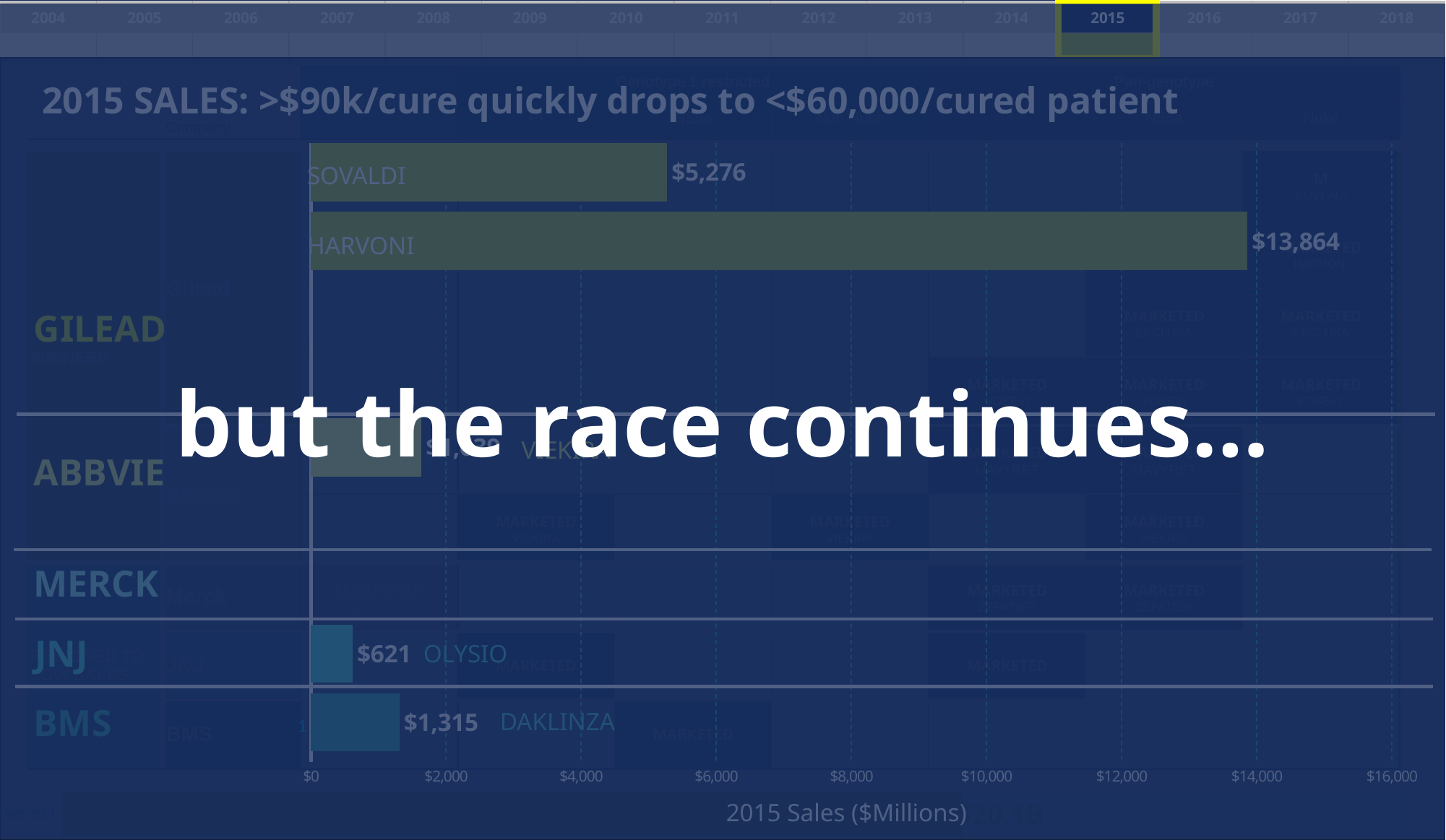
What kind of chart is shown on the slide? Bar chart How many drug bars are plotted on the chart? 5 What is the 2015 sales value shown for DAKLINZA? $1,315 What is the 2015 sales value shown for SOVALDI? $5,276 Which drug has the lowest 2015 sales on the chart? OLYSIO What is the difference between HARVONI's and SOVALDI's 2015 sales? $8,588 What is the x-axis title of the chart? 2015 Sales ($Millions) Which has higher 2015 sales, DAKLINZA or OLYSIO? DAKLINZA Is the 2015 sales value for VIEKIRA greater or less than $1,000? greater Which drug has the highest 2015 sales on the chart? HARVONI What is the 2015 sales value shown for OLYSIO? $621 What is the 2015 sales value shown for HARVONI? $13,864